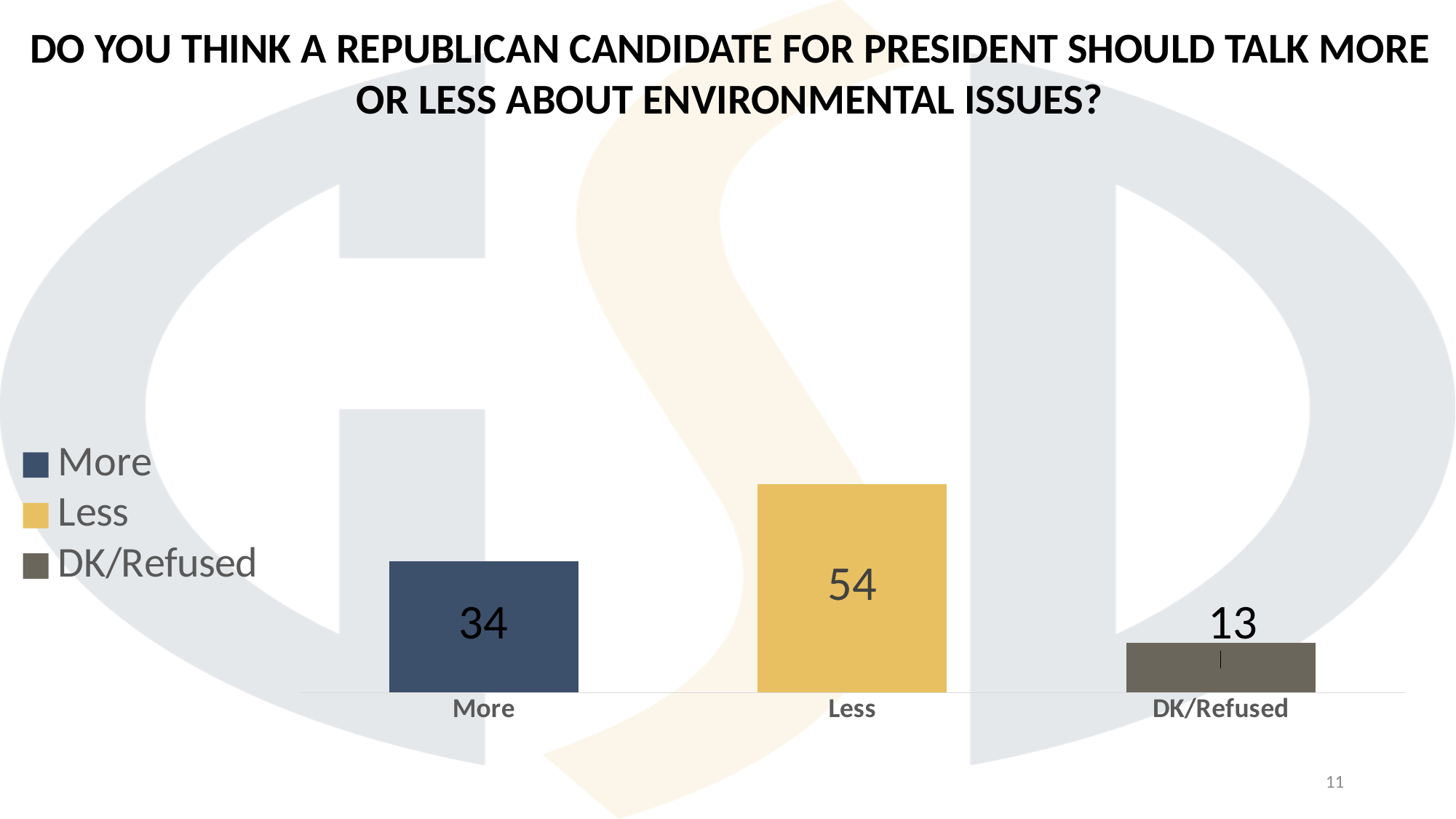
What is the value for "DK/Refused"? 13 What is the value for "More"? 34 What colour is the bar for "Less"? Yellow How many entries does the legend list? 3 How many categories are shown in the chart? 3 Which category has the highest value? Less What kind of chart is shown on the slide? Bar chart What is the difference between the values for "Less" and "More"? 20 What is the value for "Less"? 54 Which category has the lowest value? DK/Refused Which is larger, the value for "More" or the value for "Less"? Less What is the difference between the values for "More" and "DK/Refused"? 21